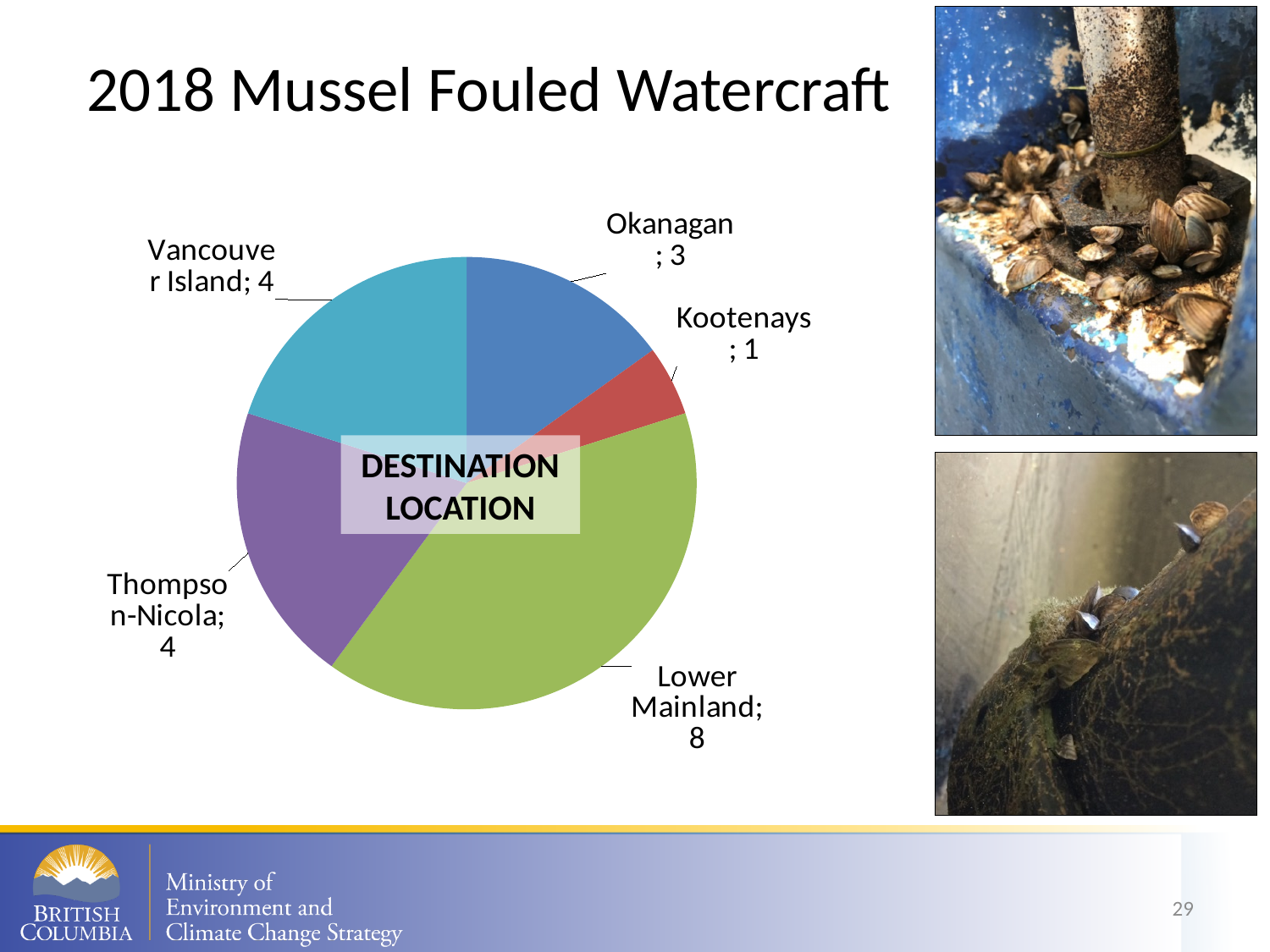
What is the difference between the values for Lower Mainland and Okanagan? 5 What is the value for Kootenays in the pie chart? 1 Which is larger, the value for Okanagan or the value for Kootenays? Okanagan How many destination locations are shown in the pie chart? 5 What is the title shown in the centre of the pie chart? DESTINATION LOCATION What is the total of all the values in the pie chart? 20 What is the value for Okanagan in the pie chart? 3 Which destination location has the smallest slice of the pie chart? Kootenays What share of the pie does Lower Mainland represent? 40% What kind of chart is shown on the slide? Pie chart What is the value for Lower Mainland in the pie chart? 8 Which destination location has the largest slice of the pie chart? Lower Mainland